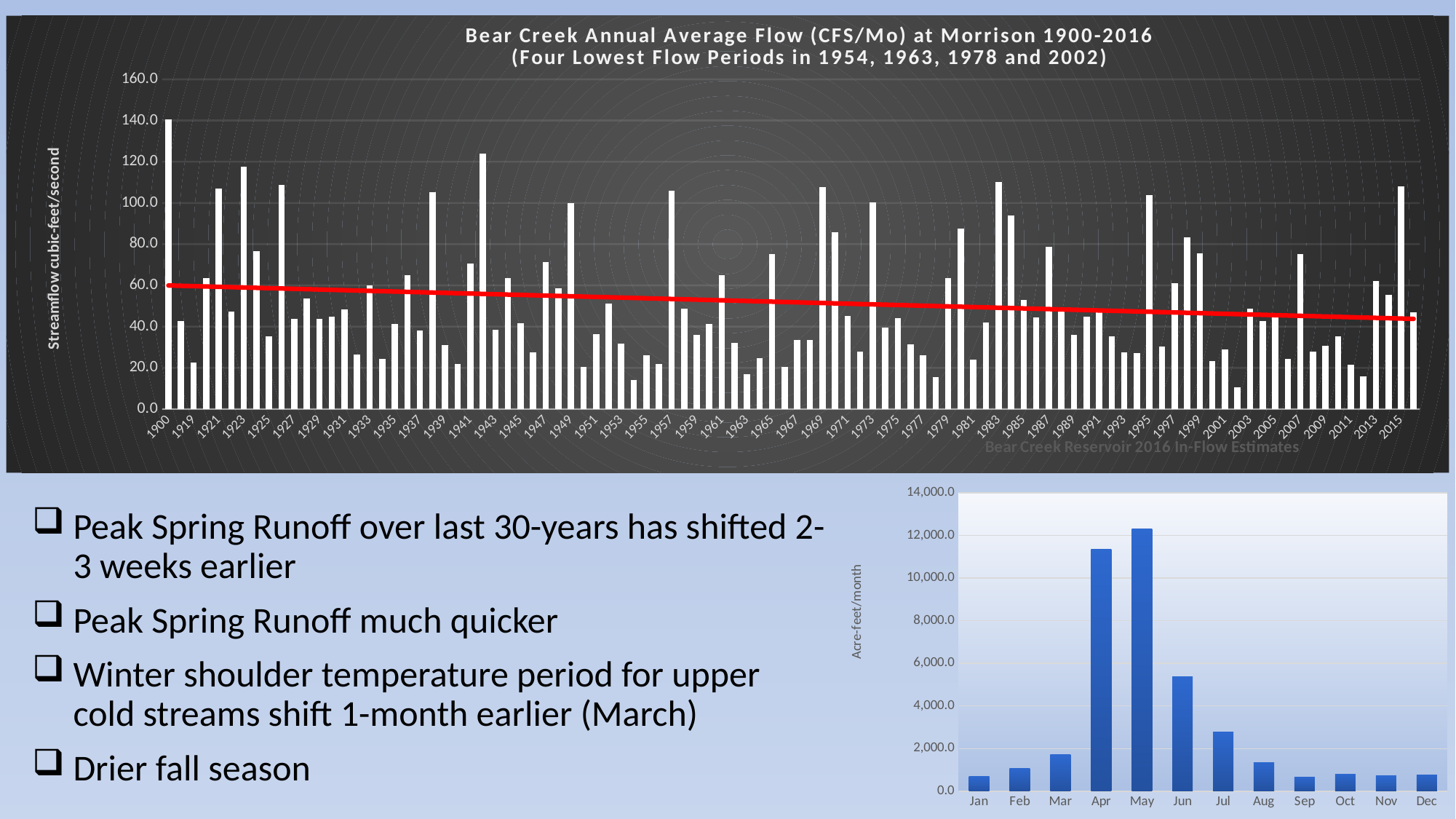
In the Bear Creek Reservoir 2016 In-Flow Estimates chart, how many months are plotted? 12 What kind of chart is the Bear Creek Reservoir 2016 In-Flow Estimates chart? bar chart In the Bear Creek Reservoir 2016 In-Flow Estimates chart, is the value for Apr greater or less than 10,000.0? greater In the Bear Creek Reservoir 2016 In-Flow Estimates chart, is the value for Jul greater or less than 4,000.0? less In the Bear Creek Annual Average Flow chart, is the value for 1900 greater or less than 120.0? greater What kind of chart is the Bear Creek Annual Average Flow (CFS/Mo) at Morrison 1900-2016 chart? bar chart In the Bear Creek Annual Average Flow chart, which four years does the title name as the lowest flow periods? 1954, 1963, 1978 and 2002 In the Bear Creek Reservoir 2016 In-Flow Estimates chart, what is the y-axis label? Acre-feet/month In the Bear Creek Reservoir 2016 In-Flow Estimates chart, which is larger, the value for Mar or the value for Jul? Jul In the Bear Creek Annual Average Flow chart, does the red trend line rise or fall from 1900 to 2016? fall In the Bear Creek Reservoir 2016 In-Flow Estimates chart, which month has the highest in-flow? May